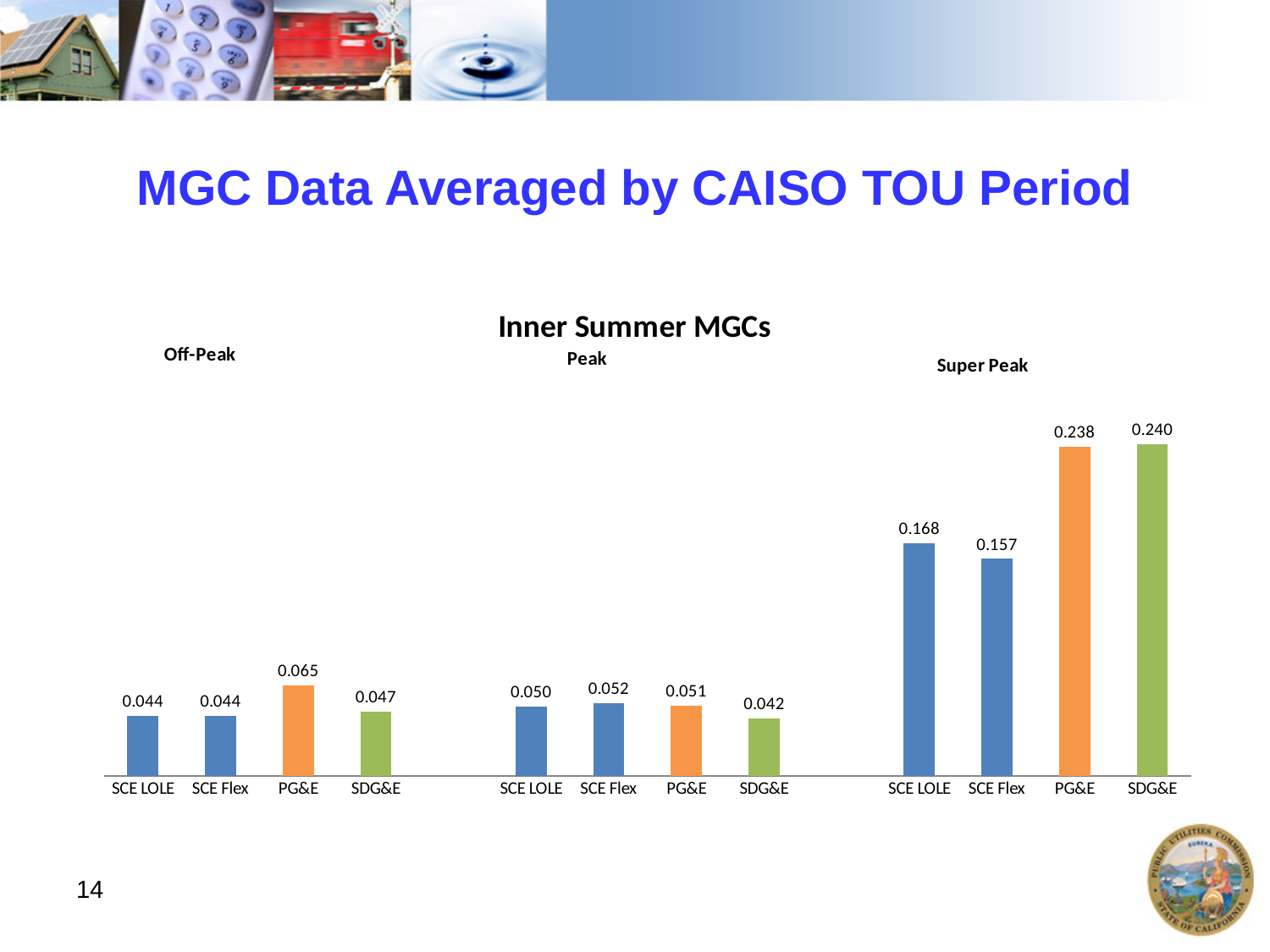
What is the value for SCE Flex in the Super Peak group? 0.157 What is the title of the chart? Inner Summer MGCs Which bar in the Super Peak group has the highest value? SDG&E Which is larger: SCE LOLE in the Super Peak group or SCE Flex in the Super Peak group? SCE LOLE What is the value for SDG&E in the Peak group? 0.042 What is the value for PG&E in the Off-Peak group? 0.065 What kind of chart is shown on the slide? Bar chart How many TOU period groups does the chart show? 3 Which bar in the Peak group has the lowest value? SDG&E What is the difference between the SDG&E and SCE LOLE values in the Super Peak group? 0.072 What is the difference between the PG&E and SDG&E values in the Off-Peak group? 0.018 How many bars are plotted in the chart in total? 12